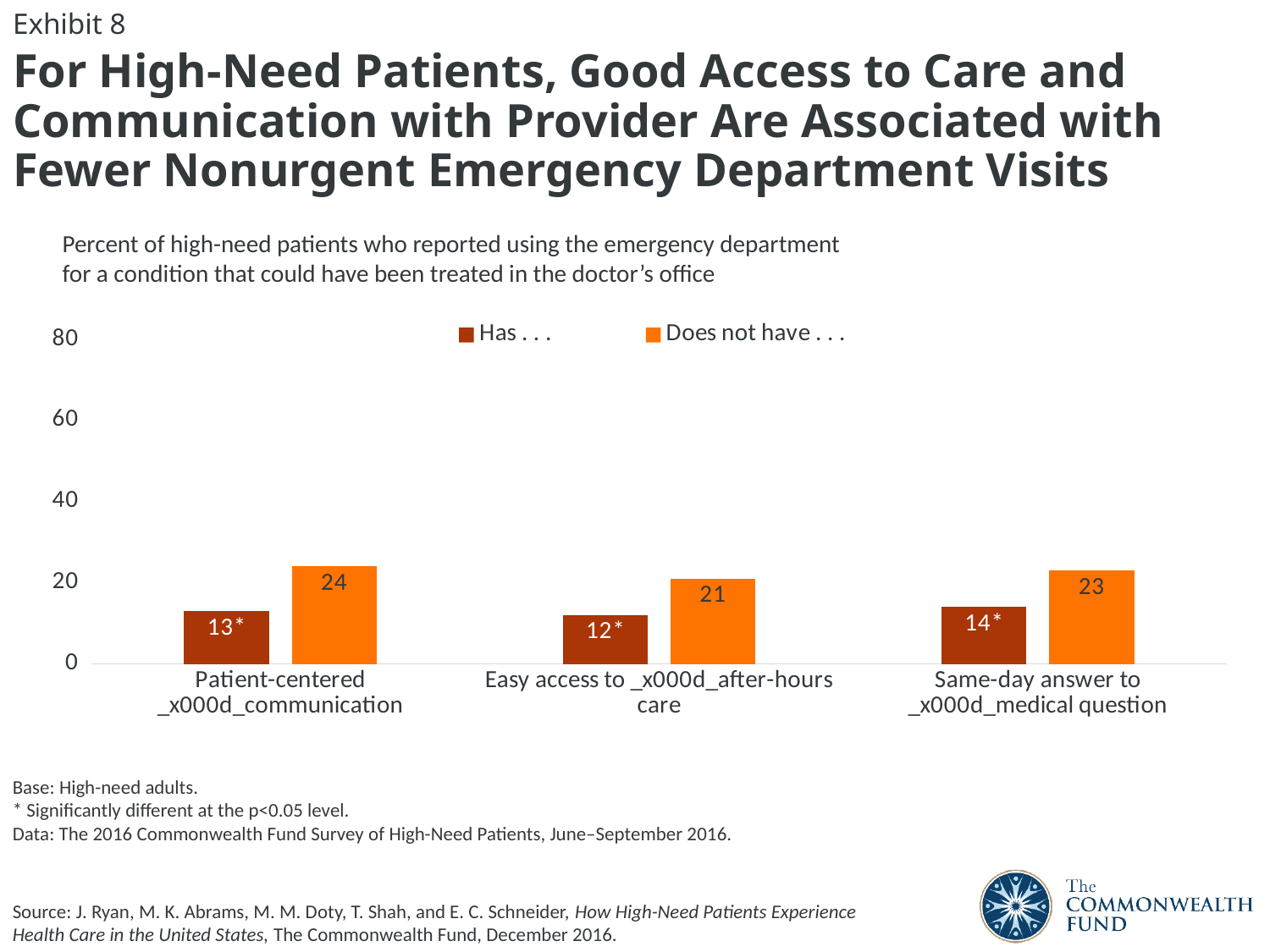
Which category has the lowest value for the "Has . . ." series? Easy access to after-hours care What is the difference between the "Does not have . . ." and "Has . . ." values for Patient-centered communication? 11 What is the value for "Does not have . . ." for Same-day answer to medical question? 23 What is the value for "Has . . ." for Easy access to after-hours care? 12 How many categories are shown on the x axis? 3 How many series does the legend list? 2 Which category has the highest value for the "Does not have . . ." series? Patient-centered communication What is the value for "Does not have . . ." for Patient-centered communication? 24 For Easy access to after-hours care, which is larger: the "Has . . ." value or the "Does not have . . ." value? Does not have . . . What is the value for "Has . . ." for Same-day answer to medical question? 14 Is the "Does not have . . ." value for Same-day answer to medical question greater or less than 20? greater What kind of chart is shown on the slide? bar chart